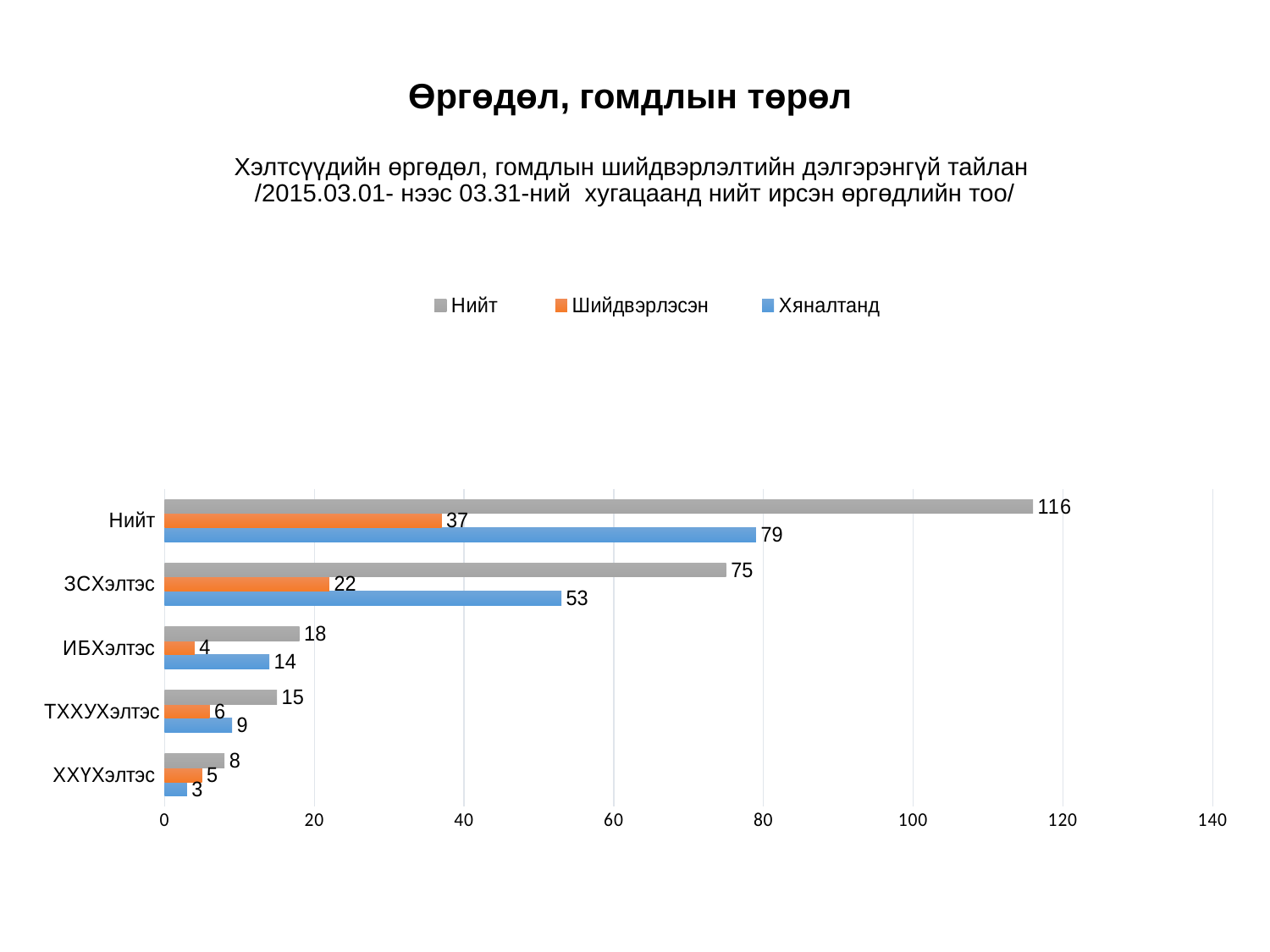
What type of chart is shown on the slide? bar chart What is the difference between the Нийт value and the Хяналтанд value for the Нийт category? 37 Which is larger for ЗСХэлтэс: the Шийдвэрлэсэн value or the Хяналтанд value? Хяналтанд What is the Хяналтанд value for ТХХУХэлтэс? 9 What is the Нийт value for ЗСХэлтэс? 75 Is the Нийт value for the Нийт category greater or less than 100? greater Which category has the highest Хяналтанд value? Нийт How many series does the legend list? 3 How many categories are shown on the vertical axis of the chart? 5 What is the Шийдвэрлэсэн value for ИБХэлтэс? 4 What colour are the Шийдвэрлэсэн bars? orange Which category has the lowest Нийт value? ХХҮХэлтэс